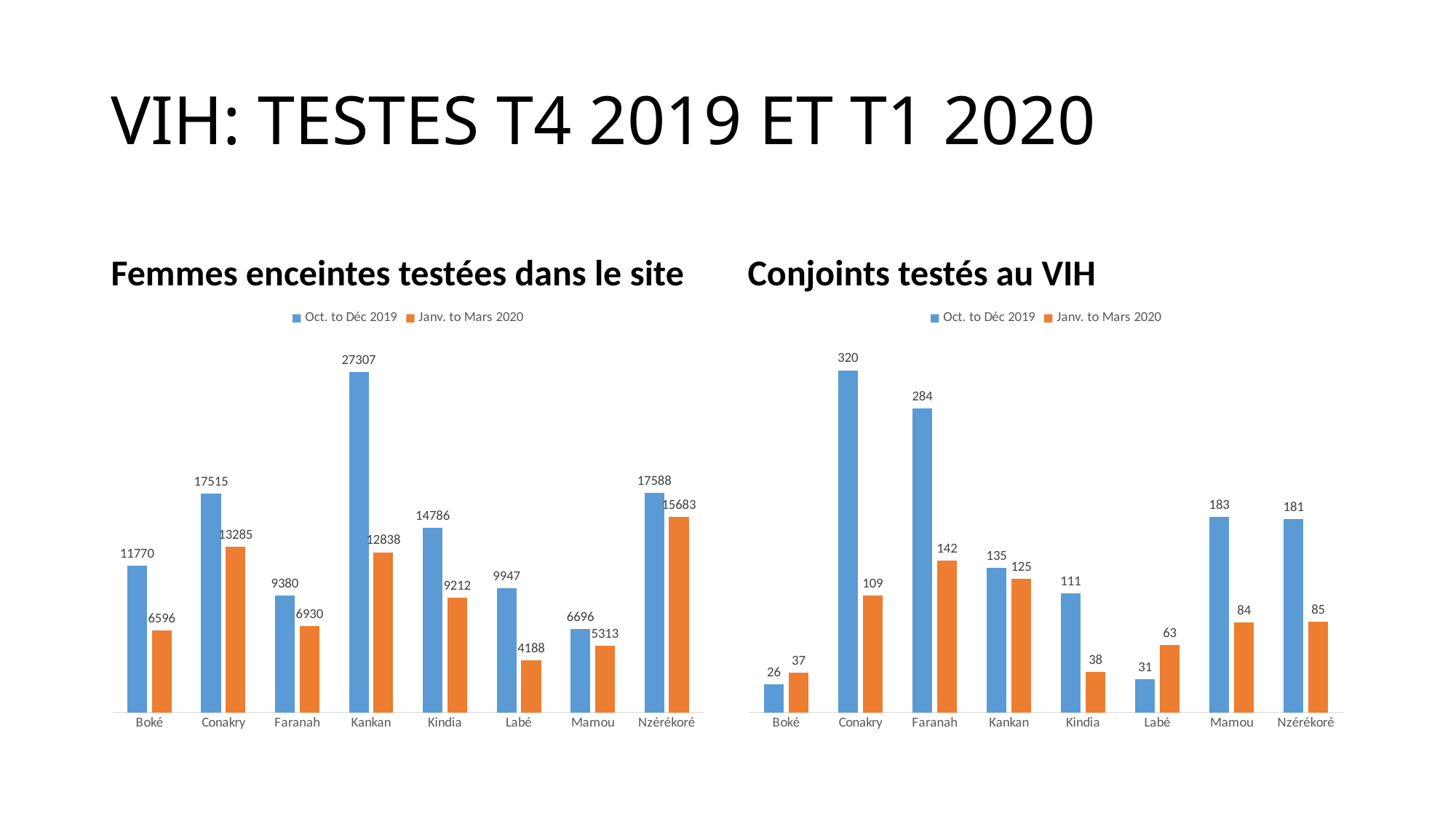
In the 'Conjoints testés au VIH' chart, which category has the highest value for Oct. to Déc 2019? Conakry In the 'Conjoints testés au VIH' chart, what is the value for Faranah in Oct. to Déc 2019? 284 In the 'Femmes enceintes testées dans le site' chart, what is the value for Kankan in Oct. to Déc 2019? 27307 In the 'Femmes enceintes testées dans le site' chart, what is the value for Labé in Janv. to Mars 2020? 4188 How many series does the legend of the 'Femmes enceintes testées dans le site' chart list? 2 In the 'Conjoints testés au VIH' chart, what is the value for Mamou in Janv. to Mars 2020? 84 In the 'Femmes enceintes testées dans le site' chart, which category has the highest value for Oct. to Déc 2019? Kankan How many categories are shown on the x axis of the 'Conjoints testés au VIH' chart? 8 In the 'Conjoints testés au VIH' chart, what is the difference between the Oct. to Déc 2019 and Janv. to Mars 2020 values for Kindia? 73 In the 'Femmes enceintes testées dans le site' chart, what is the difference between the Oct. to Déc 2019 and Janv. to Mars 2020 values for Conakry? 4230 In the 'Conjoints testés au VIH' chart, which is larger for Labé: Oct. to Déc 2019 or Janv. to Mars 2020? Janv. to Mars 2020 In the 'Femmes enceintes testées dans le site' chart, which category has the lowest value for Janv. to Mars 2020? Labé